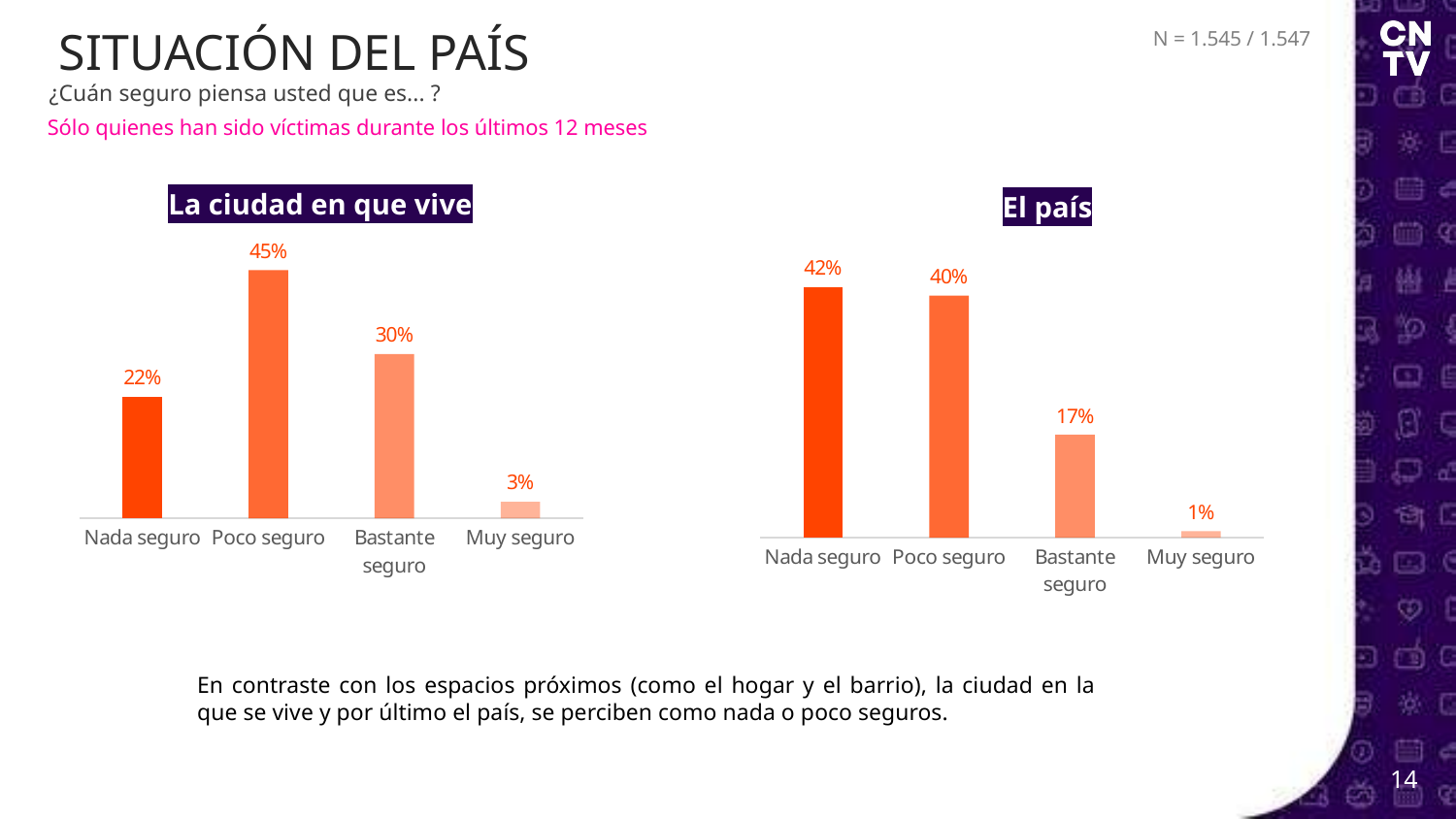
In the 'La ciudad en que vive' chart, what is the value for Muy seguro? 3% Which is larger: Nada seguro in the 'La ciudad en que vive' chart or Nada seguro in the 'El país' chart? El país In the 'La ciudad en que vive' chart, what is the difference between Poco seguro and Bastante seguro? 15% What is the title of the chart on the right side of the slide? El país In the 'El país' chart, what is the difference between Nada seguro and Poco seguro? 2% What type of chart is the 'El país' chart? Bar chart In the 'La ciudad en que vive' chart, which category has the highest value? Poco seguro In the 'La ciudad en que vive' chart, what is the value for Poco seguro? 45% In the 'El país' chart, what is the value for Bastante seguro? 17% In the 'El país' chart, which category has the lowest value? Muy seguro In the 'El país' chart, do the values rise or fall from left to right across the categories? Fall In the 'La ciudad en que vive' chart, how many categories are shown? 4